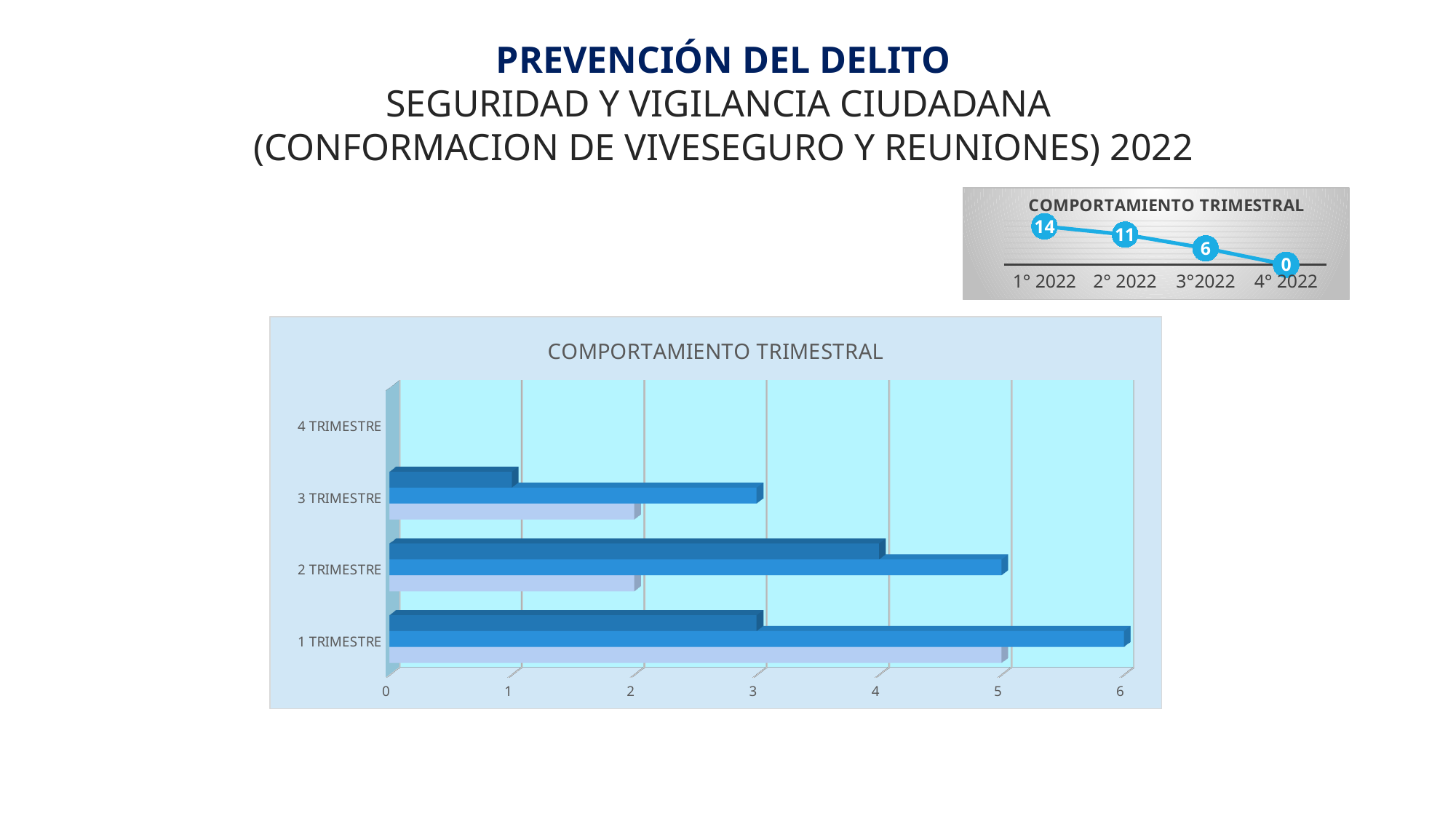
In the line chart at the top right, do the values rise or fall from 1° 2022 to 4° 2022? fall In the line chart at the top right, what is the difference between the values for 1° 2022 and 2° 2022? 3 In the line chart at the top right, how many data points are plotted? 4 In the large bar chart, how many categories are shown on the vertical axis? 4 In the line chart at the top right, what is the value for 1° 2022? 14 In the line chart at the top right, what is the value for 4° 2022? 0 In the large bar chart, which category contains the longest bar? 1 TRIMESTRE In the line chart at the top right, what is the value for 2° 2022? 11 In the line chart at the top right, which quarter has the highest value? 1° 2022 In the line chart at the top right, what is the value for 3°2022? 6 What kind of chart is the large chart in the lower part of the slide? bar chart In the line chart at the top right, which quarter has the lowest value? 4° 2022